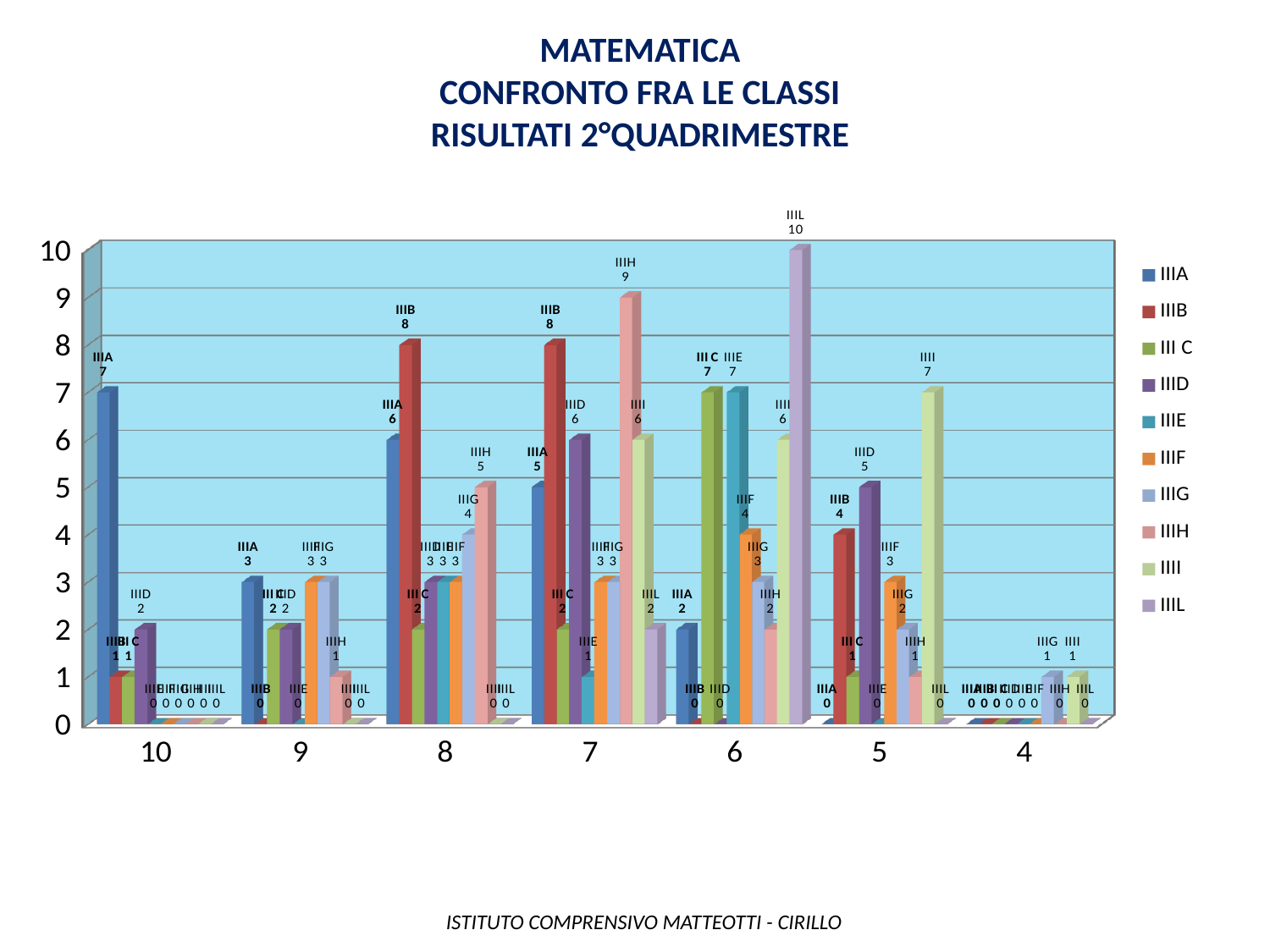
At category 7, which is larger: the value for IIIA or the value for IIID? IIID What is the value for series IIIA at category 10? 7 What is the value for series IIIH at category 7? 9 What is the first line of the chart title? MATEMATICA How many categories are shown on the x axis? 7 At category 8, what is the difference between the values for IIIB and IIIA? 2 Which series has the highest bar in the whole chart? IIIL What is the value for series IIIB at category 8? 8 How many series does the legend list? 10 What is the value for series IIIL at category 6? 10 What kind of chart is shown on the slide? Bar chart What is the value for series IIII at category 5? 7